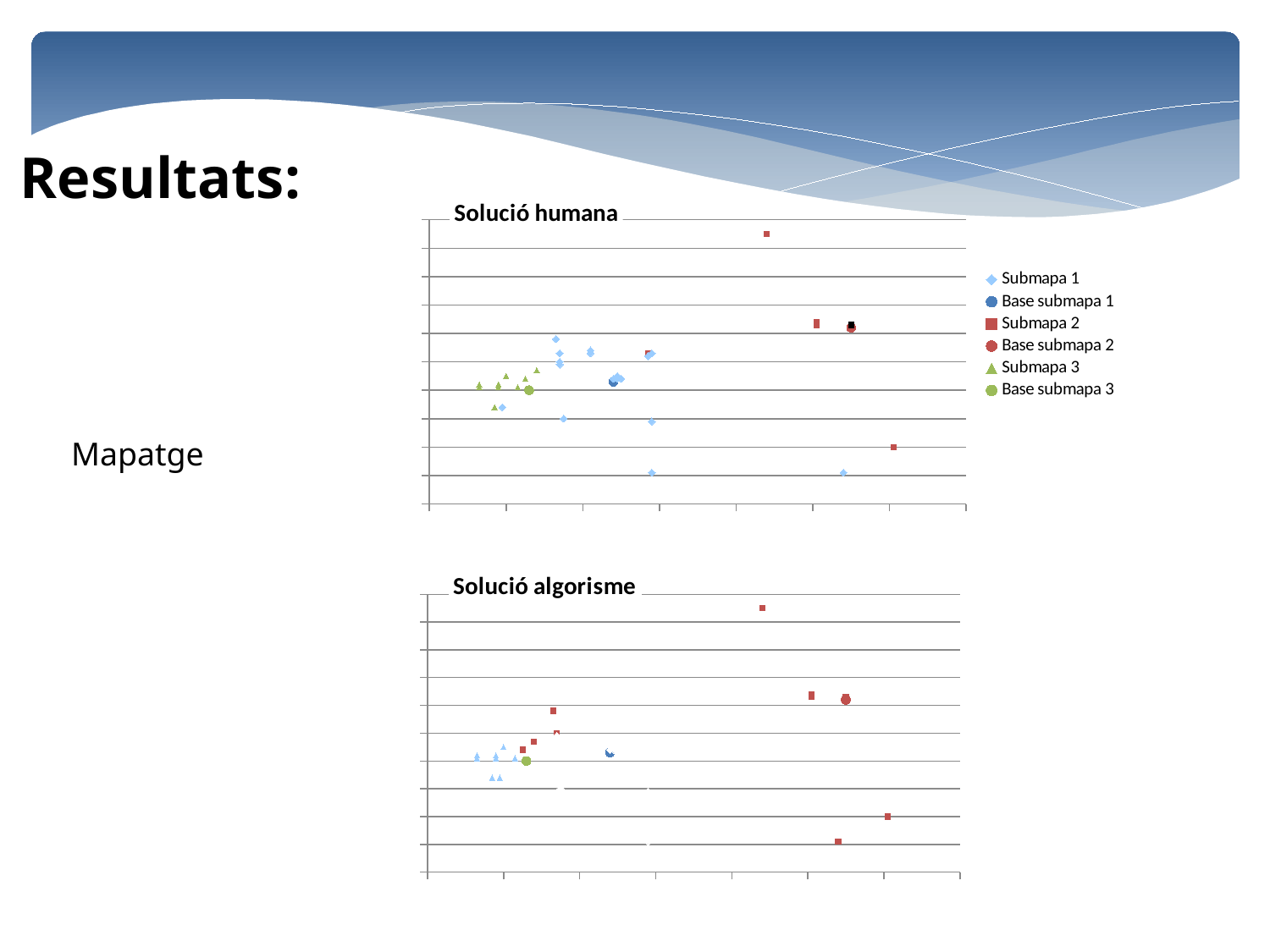
Which series is drawn with green triangle markers? Submapa 3 In the "Solució humana" chart, which series has the lowest plotted points? Submapa 1 In the "Solució algorisme" chart, which series has the lowest plotted point? Submapa 2 In the "Solució humana" chart, which series has the highest plotted point? Submapa 2 In the "Solució algorisme" chart, is the Base submapa 3 marker plotted higher or lower than the Base submapa 2 marker? lower What kind of chart is the "Solució humana" chart? scatter chart What is the title of the top chart on the slide? Solució humana How many series does the legend list? 6 In the "Solució humana" chart, is the Base submapa 2 marker plotted higher or lower than the Base submapa 1 marker? higher What kind of chart is the "Solució algorisme" chart? scatter chart